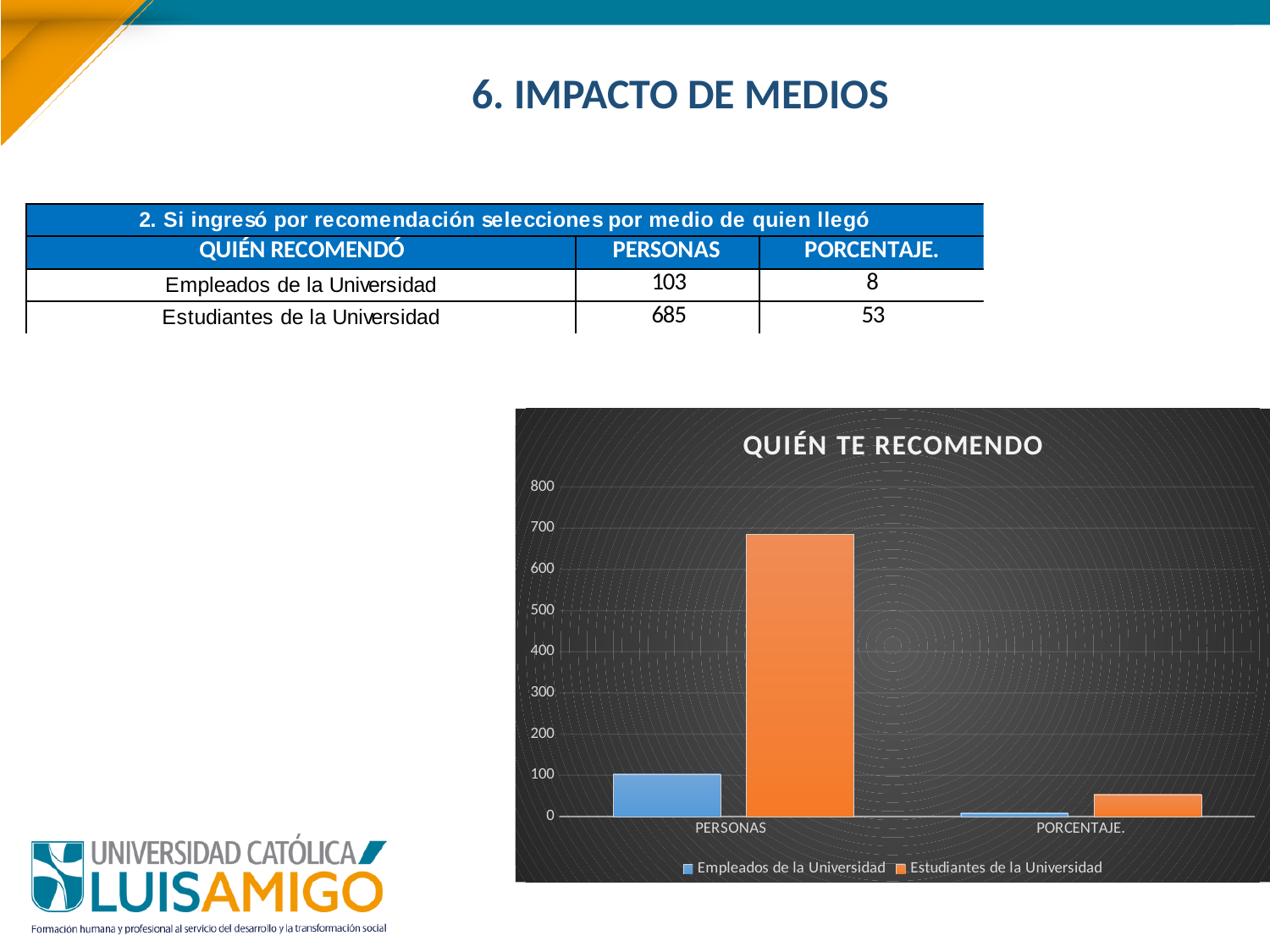
What is the PORCENTAJE value for Empleados de la Universidad? 8 How many series does the legend of the chart list? 2 How many categories are shown on the x axis of the chart? 2 Is the PERSONAS value for Estudiantes de la Universidad greater or less than 600? greater What is the PERSONAS value for Empleados de la Universidad? 103 What is the difference in PERSONAS between Estudiantes de la Universidad and Empleados de la Universidad? 582 What is the PORCENTAJE value for Estudiantes de la Universidad? 53 Which series has the higher PERSONAS value? Estudiantes de la Universidad What is the title of the chart? QUIÉN TE RECOMENDO Is the PERSONAS value for Empleados de la Universidad greater or less than 200? less What is the PERSONAS value for Estudiantes de la Universidad? 685 What kind of chart is shown on the slide? bar chart